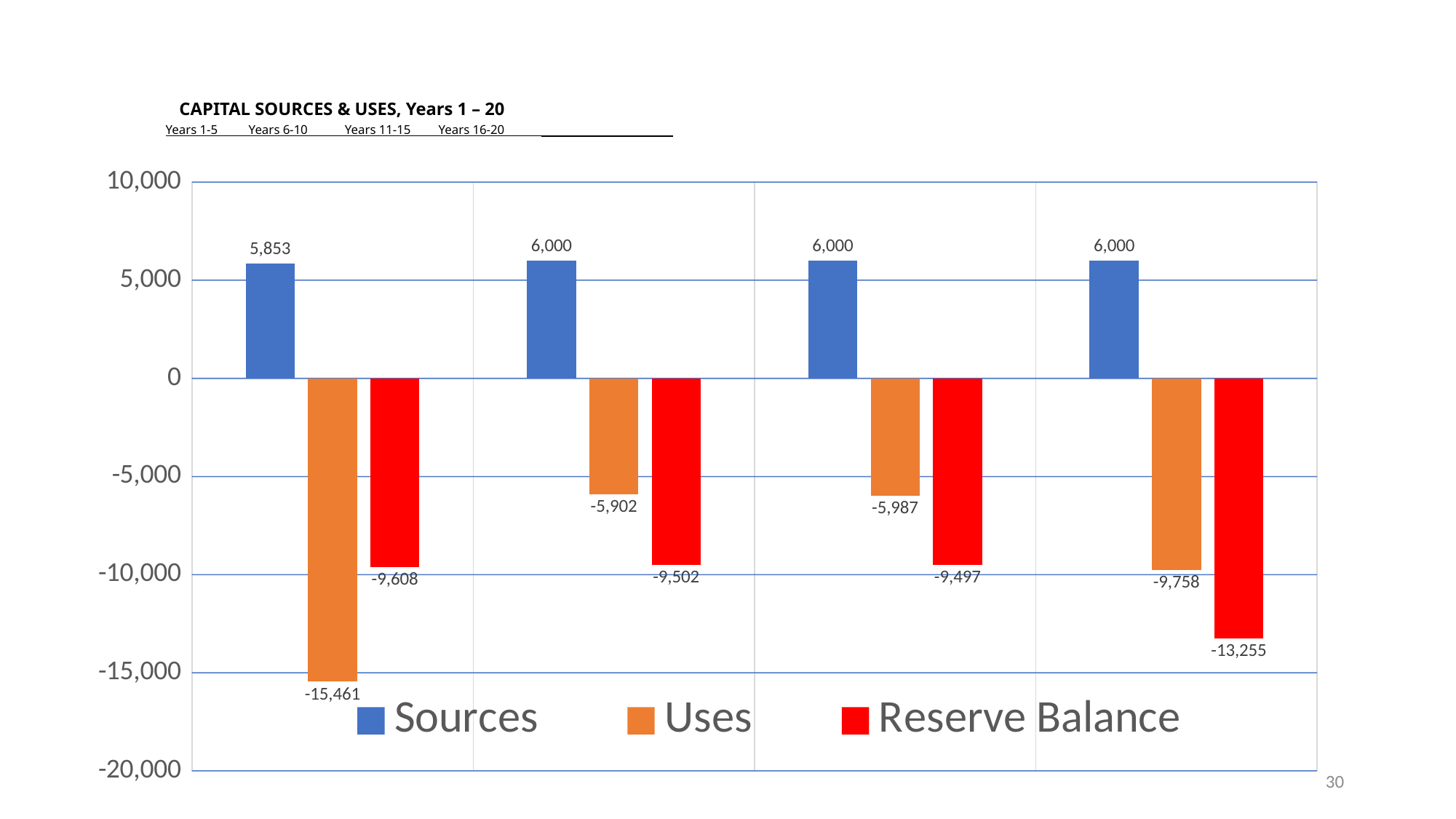
Which is lower, the Reserve Balance for Years 1-5 or for Years 16-20? Years 16-20 What is the Reserve Balance for Years 16-20? -13,255 What type of chart is shown on the slide? bar chart Is the value of Sources for Years 1-5 greater or less than 5,000? greater How many time periods are shown in the chart? 4 What is the value of Uses for Years 1-5? -15,461 What is the value of Uses for Years 11-15? -5,987 Which period has the lowest (most negative) Reserve Balance? Years 16-20 What is the difference between the Reserve Balance for Years 16-20 and for Years 1-5? 3,647 What is the value of Sources for Years 1-5? 5,853 Which period has the lowest (most negative) Uses value? Years 1-5 How many series does the legend list? 3